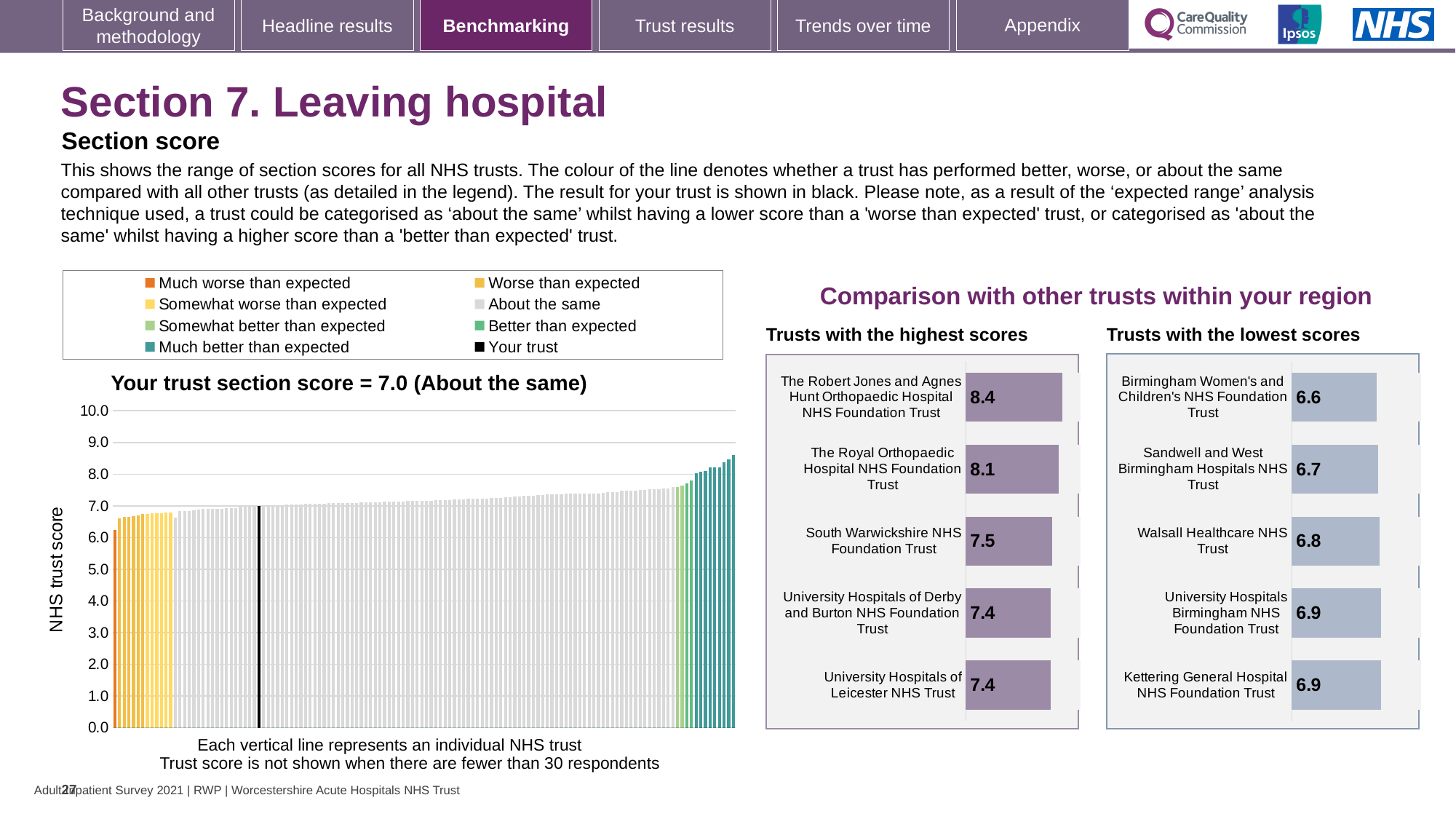
In the 'Your trust section score' chart, which category does your trust fall into? About the same In the 'Trusts with the highest scores' chart, which trust has the highest score? The Robert Jones and Agnes Hunt Orthopaedic Hospital NHS Foundation Trust In the 'Your trust section score' chart, do the trust scores rise or fall from left to right? rise How many trusts are shown in the 'Trusts with the lowest scores' chart? 5 In the 'Trusts with the lowest scores' chart, which trust has the lowest score? Birmingham Women's and Children's NHS Foundation Trust In the 'Trusts with the lowest scores' chart, what is the score for Walsall Healthcare NHS Trust? 6.8 In the 'Trusts with the highest scores' chart, what is the difference between the scores of The Robert Jones and Agnes Hunt Orthopaedic Hospital NHS Foundation Trust and The Royal Orthopaedic Hospital NHS Foundation Trust? 0.3 In the 'Trusts with the highest scores' chart, what is the score for The Robert Jones and Agnes Hunt Orthopaedic Hospital NHS Foundation Trust? 8.4 In the 'Your trust section score' chart, what is the section score for your trust? 7.0 How many entries does the legend above the 'Your trust section score' chart list? 8 In the 'Your trust section score' chart, is the value of the tallest bar greater or less than 8.0? greater What kind of chart is the 'Your trust section score' chart? bar chart